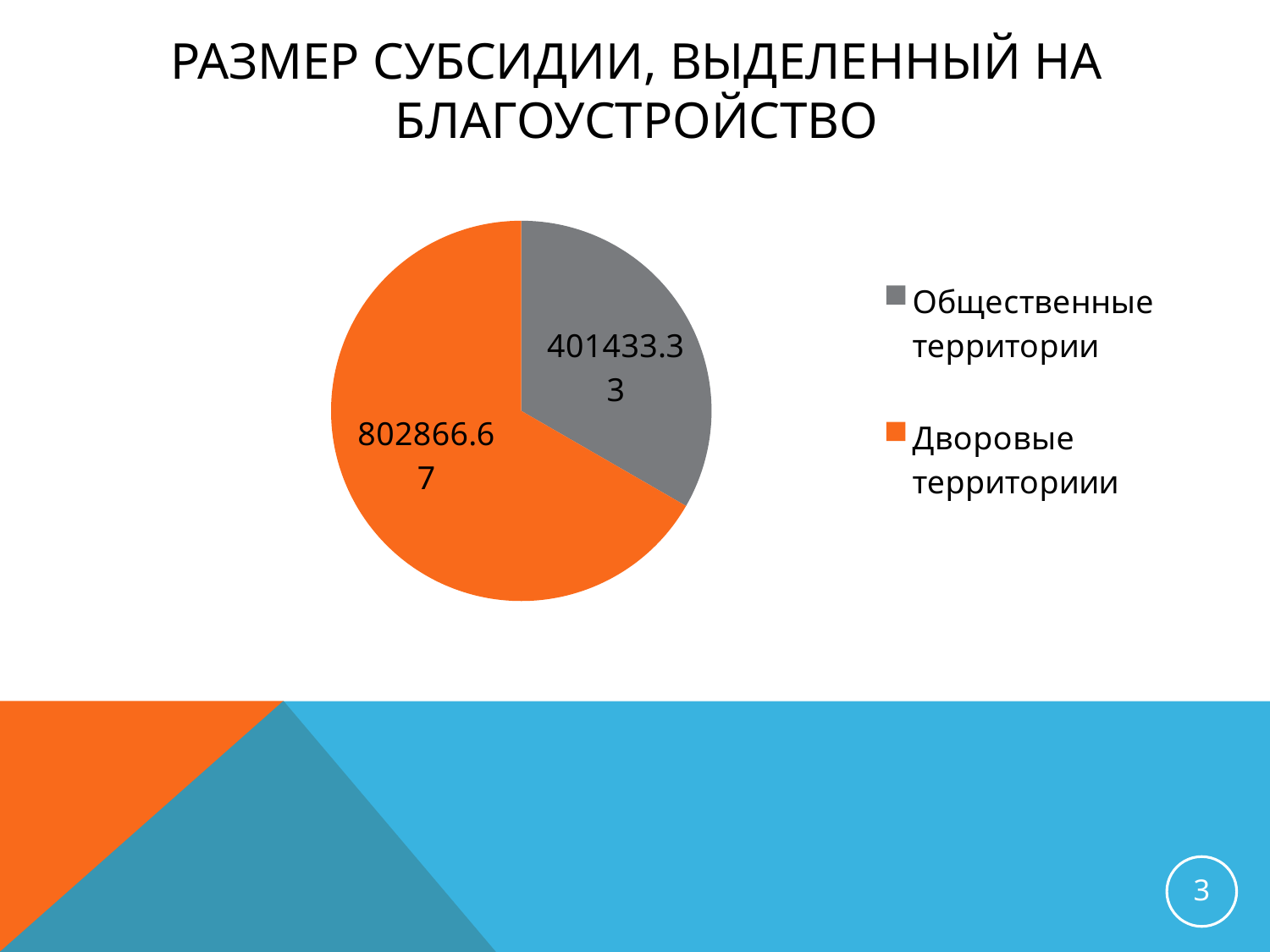
What is the difference between the value for Дворовые территориии and the value for Общественные территории? 401433.34 How many entries does the legend list? 2 Which is larger, the value for Общественные территории or the value for Дворовые территориии? Дворовые территориии Which category has the largest slice of the pie? Дворовые территориии What is the value for Дворовые территориии? 802866.67 What share of the pie does Дворовые территориии represent? 66.67% How many slices does the pie chart have? 2 Which category has the smallest slice of the pie? Общественные территории What is the total of the two values shown in the pie chart? 1204300 What kind of chart is shown on the slide? Pie chart What is the value for Общественные территории? 401433.33 What colour is the slice for Общественные территории? Gray